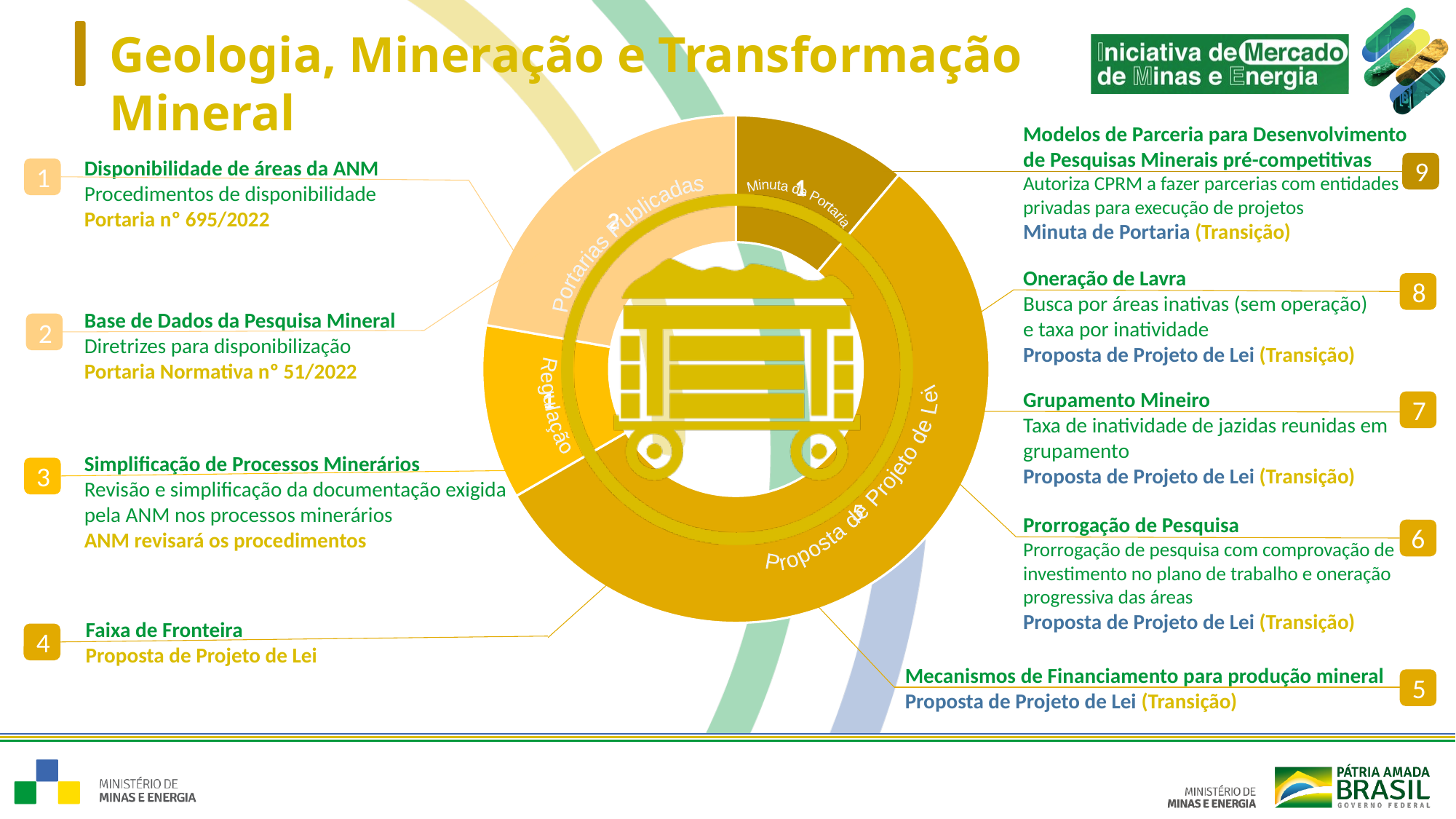
Which segment of the doughnut chart is drawn in the lightest (pale orange) colour? Portarias Publicadas Which segment is larger in the doughnut chart, Proposta de Projeto de Lei or Regulação? Proposta de Projeto de Lei Which segment of the doughnut chart is the largest? Proposta de Projeto de Lei Does the Proposta de Projeto de Lei segment cover more or less than a quarter of the doughnut chart? more Which segment is larger in the doughnut chart, Proposta de Projeto de Lei or Portarias Publicadas? Proposta de Projeto de Lei What value is shown on the Portarias Publicadas segment of the doughnut chart? 2 Does the Minuta de Portaria segment cover more or less than a quarter of the doughnut chart? less How many segments does the doughnut chart have? 4 Which segment is larger in the doughnut chart, Portarias Publicadas or Minuta de Portaria? Portarias Publicadas What value is shown on the Minuta de Portaria segment of the doughnut chart? 1 What is the title of the slide containing the doughnut chart? Geologia, Mineração e Transformação Mineral What kind of chart is shown in the centre of the slide? Doughnut (pie) chart